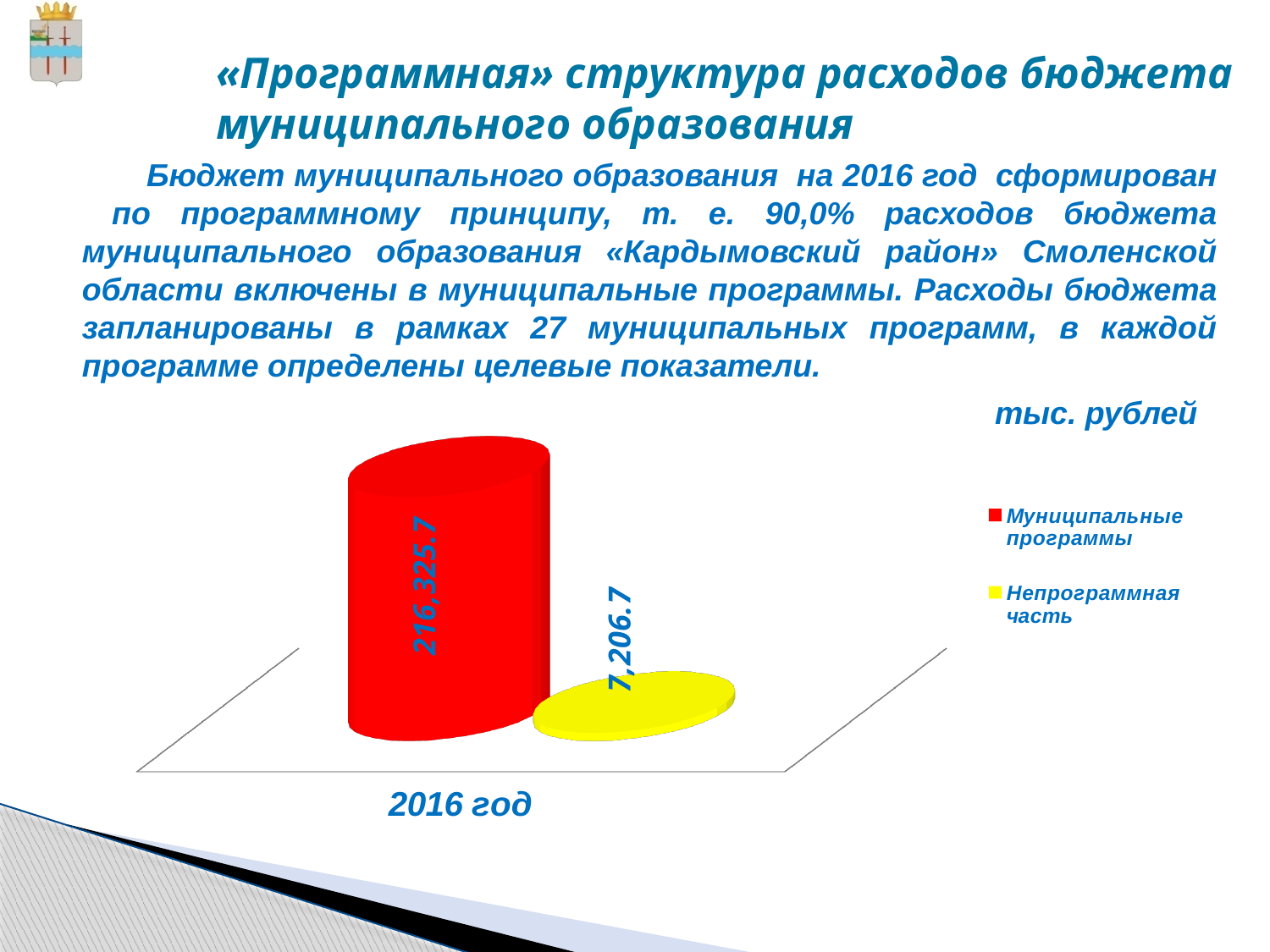
How many categories are shown on the x axis? 1 What unit is indicated for the chart values? тыс. рублей What kind of chart is shown on the slide? Bar chart What colour represents Непрограммная часть in the chart? Yellow What is the value for Непрограммная часть in 2016 год? 7,206.7 Which series has the lowest value in 2016 год? Непрограммная часть How many series does the legend list? 2 What is the difference between the values for Муниципальные программы and Непрограммная часть? 209,119.0 What is the total of the two plotted values for 2016 год? 223,532.4 Which series has the highest value in 2016 год? Муниципальные программы What is the value for Муниципальные программы in 2016 год? 216,325.7 Which is larger: the value for Муниципальные программы or the value for Непрограммная часть? Муниципальные программы